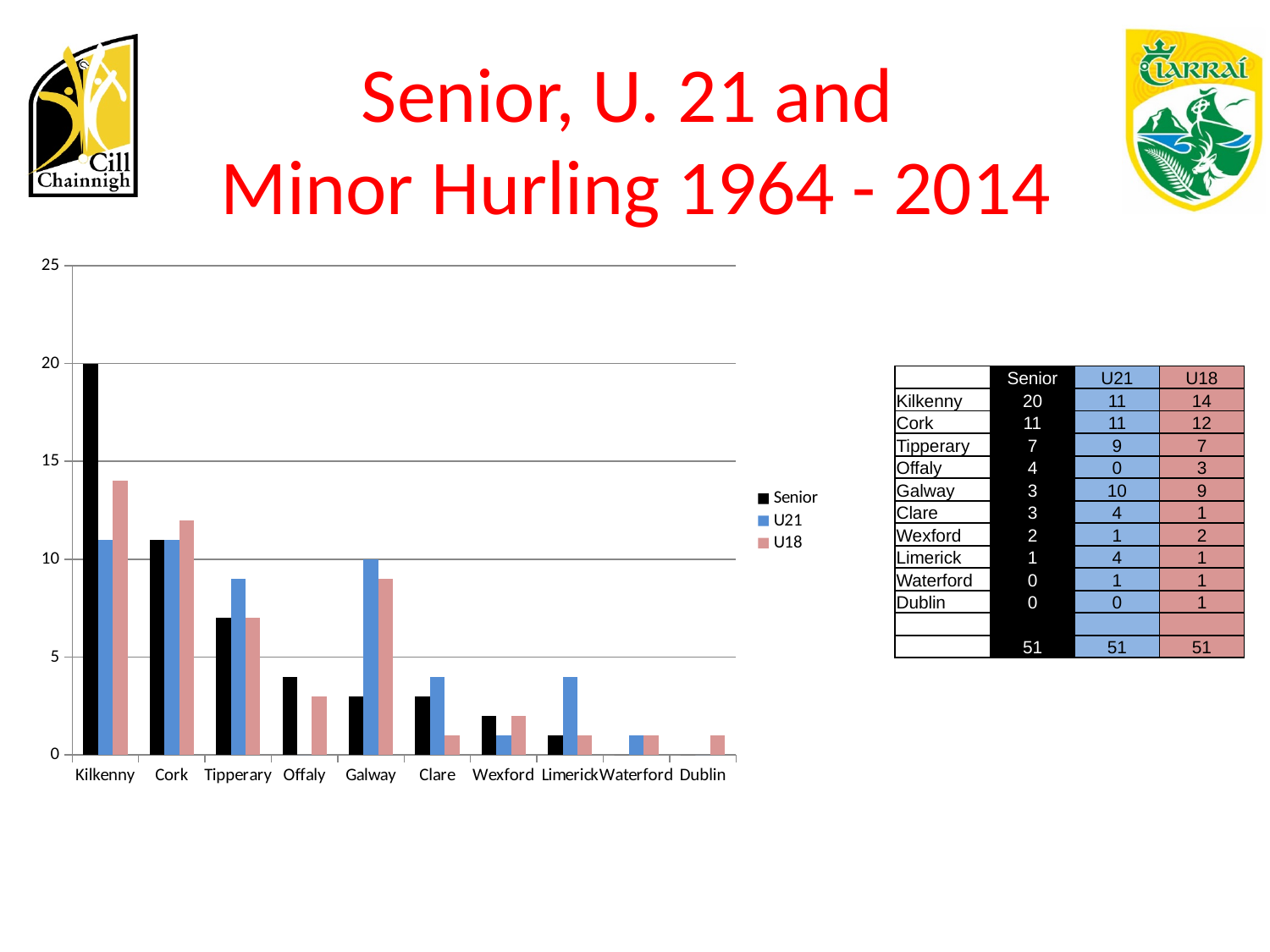
Is the Senior value for Kilkenny greater or less than 15? greater How many series does the chart legend list? 3 What is the difference between Kilkenny's Senior value and Cork's Senior value? 9 Which is larger for Galway: the Senior value or the U21 value? U21 What is the Senior value for Kilkenny? 20 How many counties are shown along the x axis of the chart? 10 Which county has the highest Senior value? Kilkenny What is the U21 value for Galway? 10 Which series is shown in black in the chart? Senior What kind of chart is shown on the slide? bar chart What is the U18 value for Cork? 12 Which county has the highest U21 value? Kilkenny and Cork (11 each)